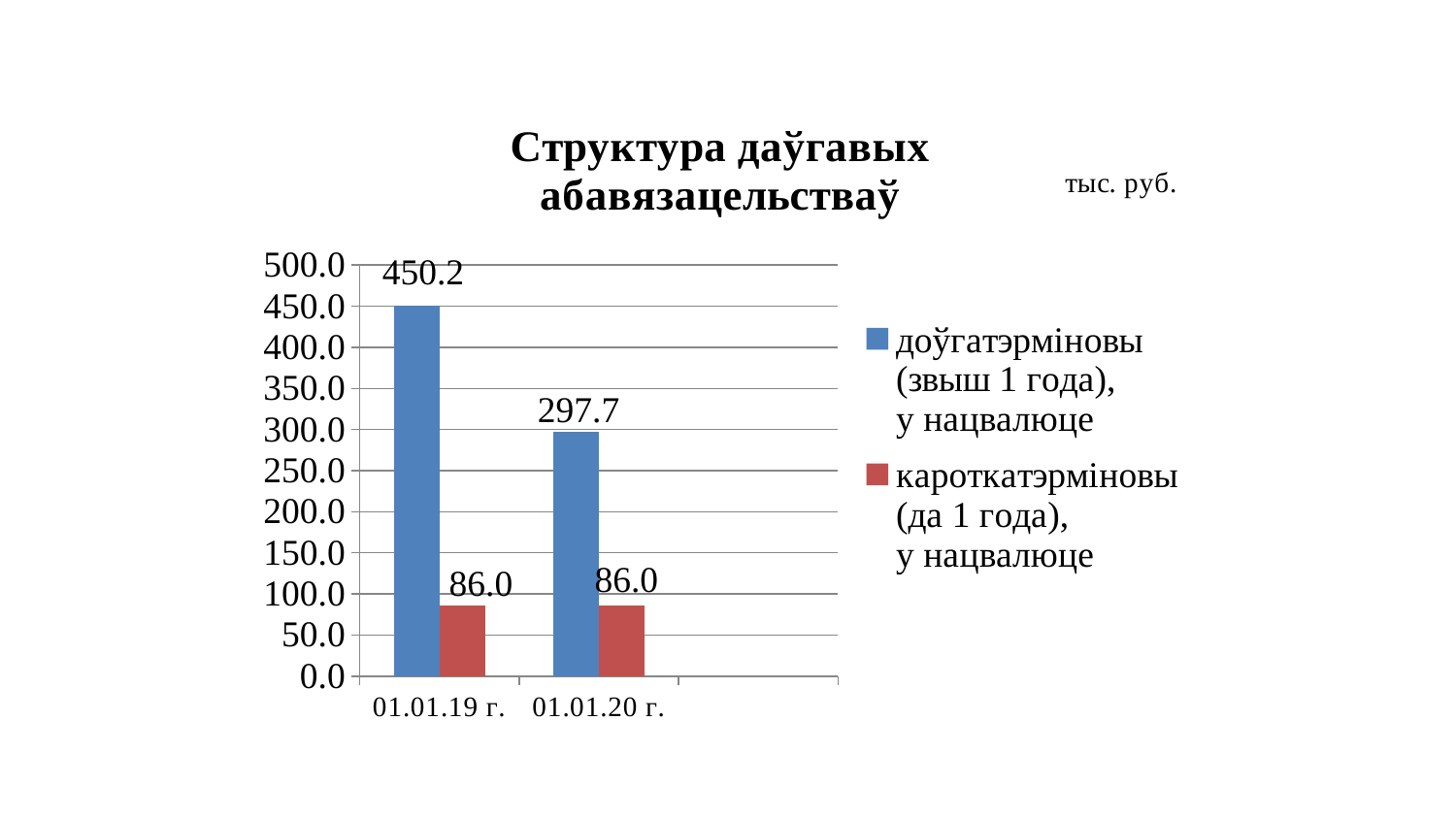
How many dates (categories) are shown on the x axis? 2 What is the value of the short-term (кароткатэрміновы) series for 01.01.20 г.? 86.0 What is the value of the long-term (доўгатэрміновы) series for 01.01.19 г.? 450.2 Is the long-term value for 01.01.20 г. greater or less than 300.0? less What is the value of the long-term (доўгатэрміновы) series for 01.01.20 г.? 297.7 What is the value of the short-term (кароткатэрміновы) series for 01.01.19 г.? 86.0 How many series does the legend list? 2 Which date has the higher value for the long-term (доўгатэрміновы) series? 01.01.19 г. On 01.01.19 г., which series has the larger value: long-term or short-term? доўгатэрміновы (звыш 1 года), у нацвалюце What is the difference between the long-term and short-term values on 01.01.20 г.? 211.7 By how much did the long-term (доўгатэрміновы) value decrease from 01.01.19 г. to 01.01.20 г.? 152.5 What type of chart is shown on the slide? bar chart